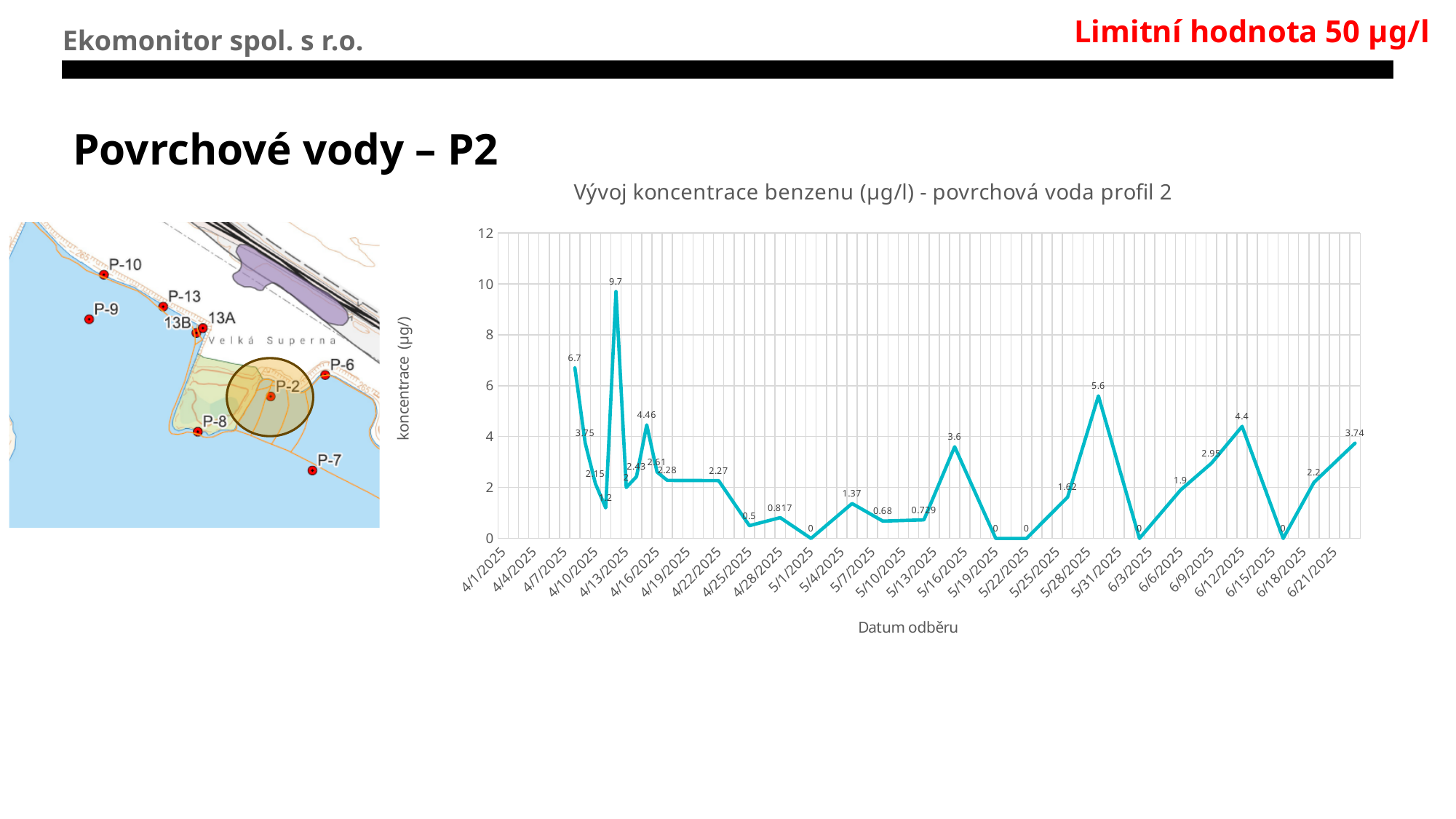
What is the label of the x axis? Datum odběru What is the title of the chart? Vývoj koncentrace benzenu (µg/l) - povrchová voda profil 2 What is the highest benzene concentration value plotted on the chart? 9.7 What is the benzene concentration on 6/12/2025? 4.4 What kind of chart is shown on the slide? line chart